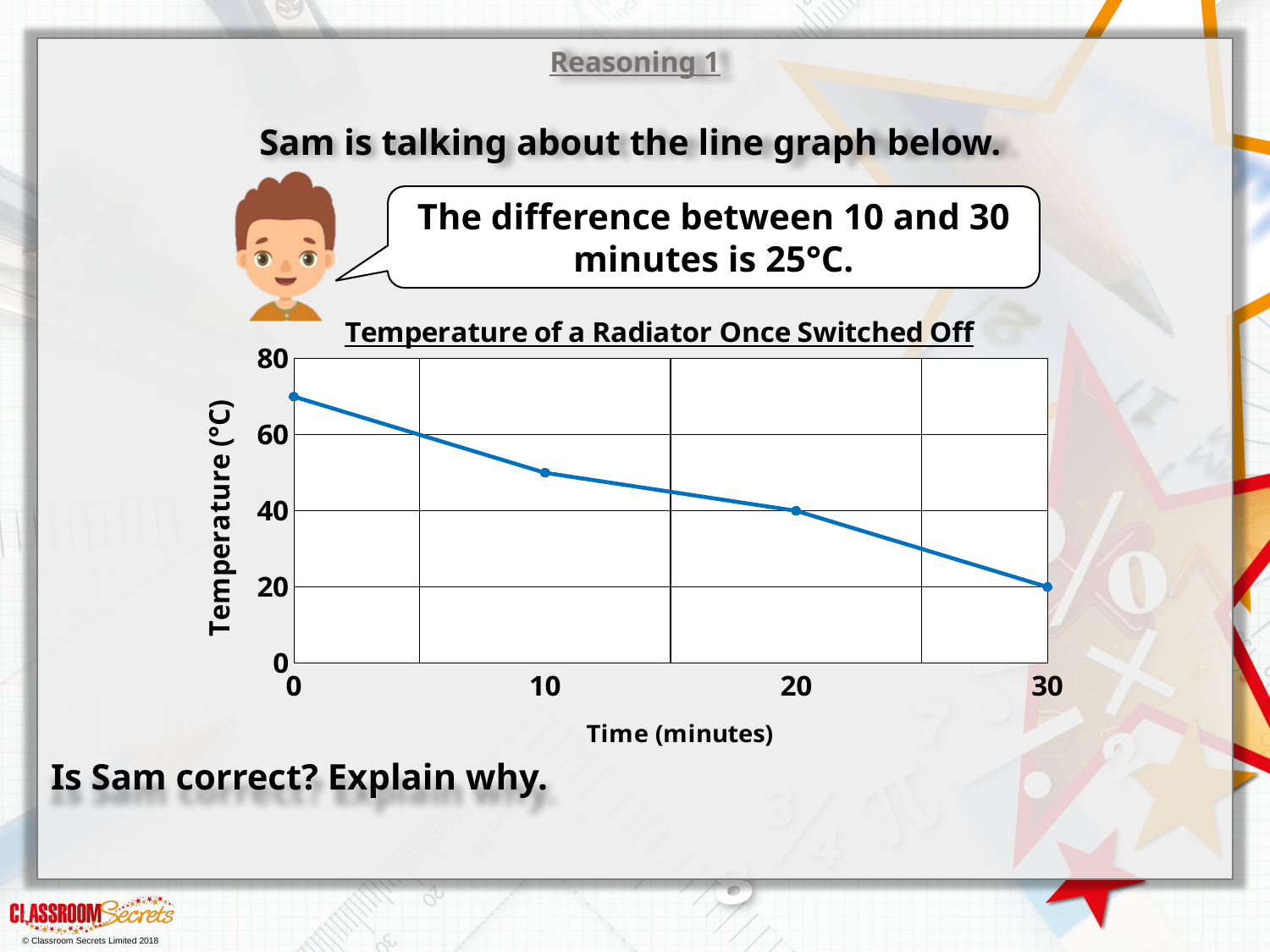
How many data points are plotted on the line? 4 At which time is the temperature lowest? 30 minutes What is the temperature at 30 minutes? 20 What is the temperature at 20 minutes? 40 What is the title of the chart? Temperature of a Radiator Once Switched Off Is the temperature at 0 minutes greater or less than 60? greater Which is higher, the temperature at 10 minutes or at 30 minutes? 10 minutes Does the temperature rise or fall as time increases? fall What is the difference between the temperature at 20 minutes and at 30 minutes? 20 What type of chart is shown on the slide? line chart Is the temperature at 10 minutes greater or less than 60? less At which time is the temperature highest? 0 minutes